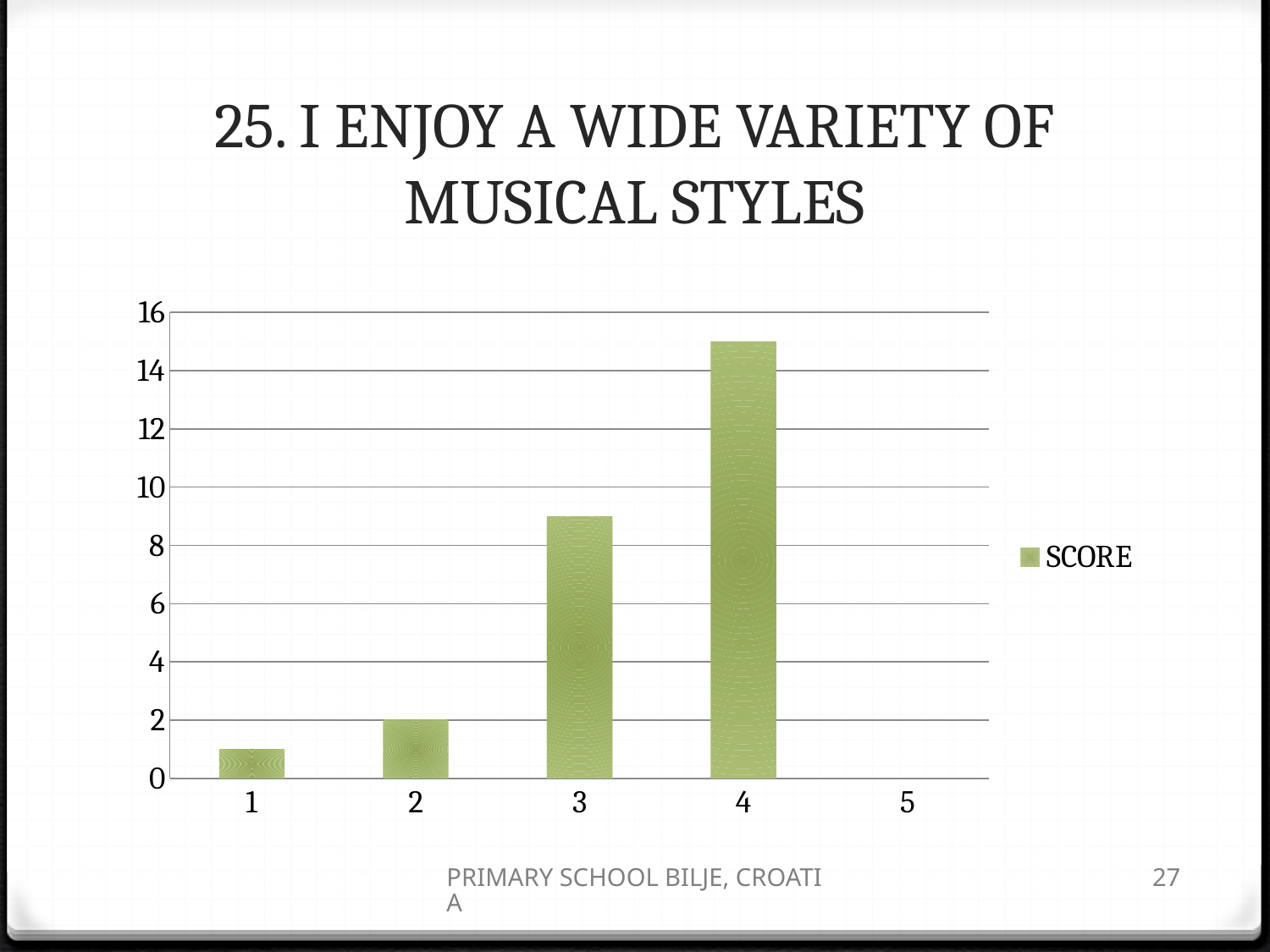
What is the SCORE value for category 2? 2 How many series does the legend list? 1 Which category has the highest SCORE? 4 Is the SCORE value for category 3 greater or less than 10? less Do the SCORE values rise or fall from category 1 to category 4? rise Is the SCORE value for category 4 greater or less than 14? greater What is the SCORE value for category 5? 0 Which category has the lowest SCORE? 5 How many categories are shown on the x axis? 5 Which has a larger SCORE, category 3 or category 4? 4 What kind of chart is shown on the slide? bar chart What is the name of the series shown in the legend? SCORE